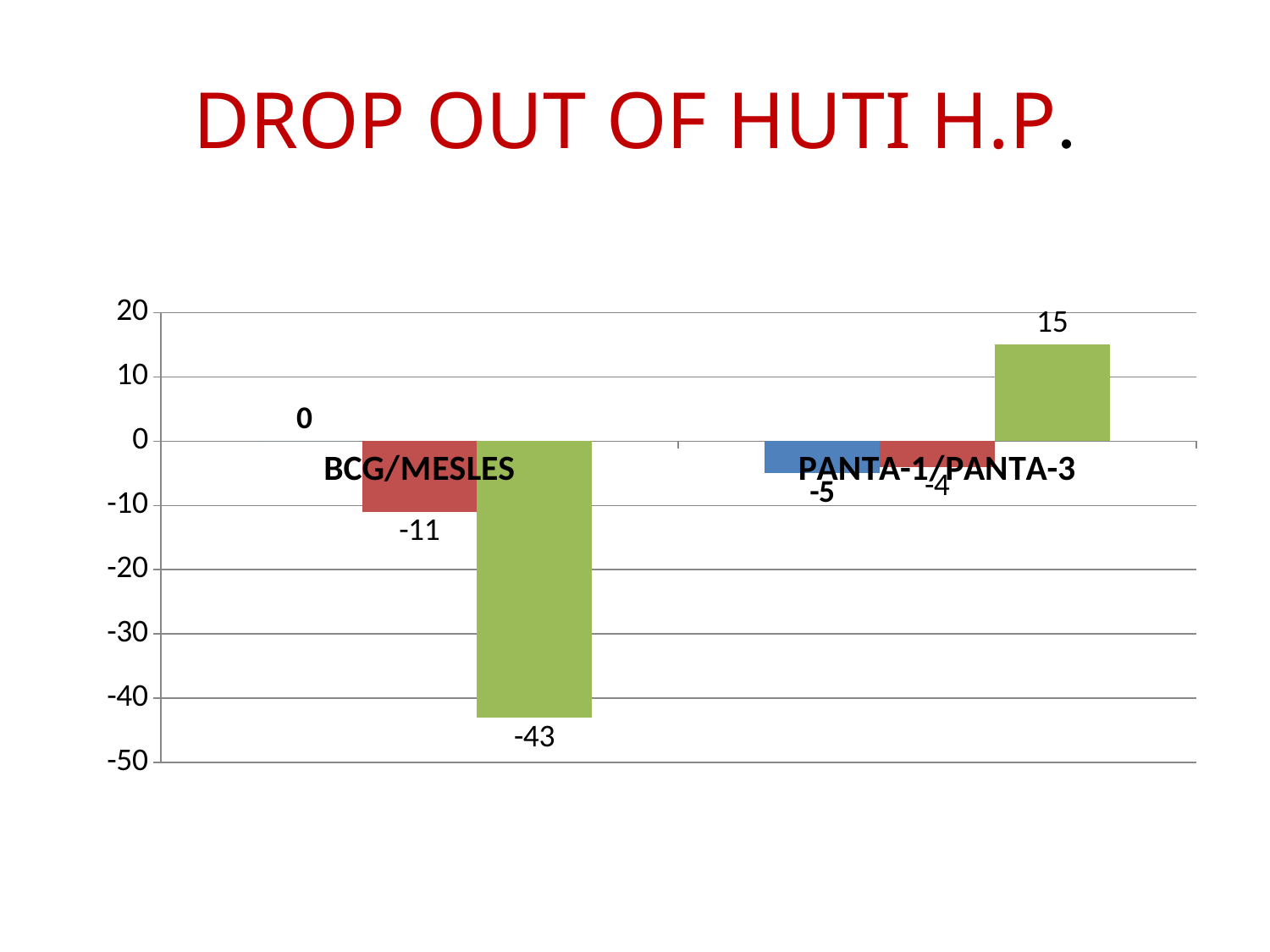
What is the difference between the green bar values for PANTA-1/PANTA-3 and BCG/MESLES? 58 Which bar has the highest value in the chart? the green bar for PANTA-1/PANTA-3 (15) What kind of chart is shown on the slide? bar chart What is the value of the green bar for PANTA-1/PANTA-3? 15 Which bar has the lowest value in the chart? the green bar for BCG/MESLES (-43) What is the title of the slide? DROP OUT OF HUTI H.P. What is the value of the blue bar for BCG/MESLES? 0 What is the value of the red bar for PANTA-1/PANTA-3? -4 How many categories are shown on the x axis of the chart? 2 What is the value of the blue bar for PANTA-1/PANTA-3? -5 What is the value of the green bar for BCG/MESLES? -43 What is the value of the red bar for BCG/MESLES? -11